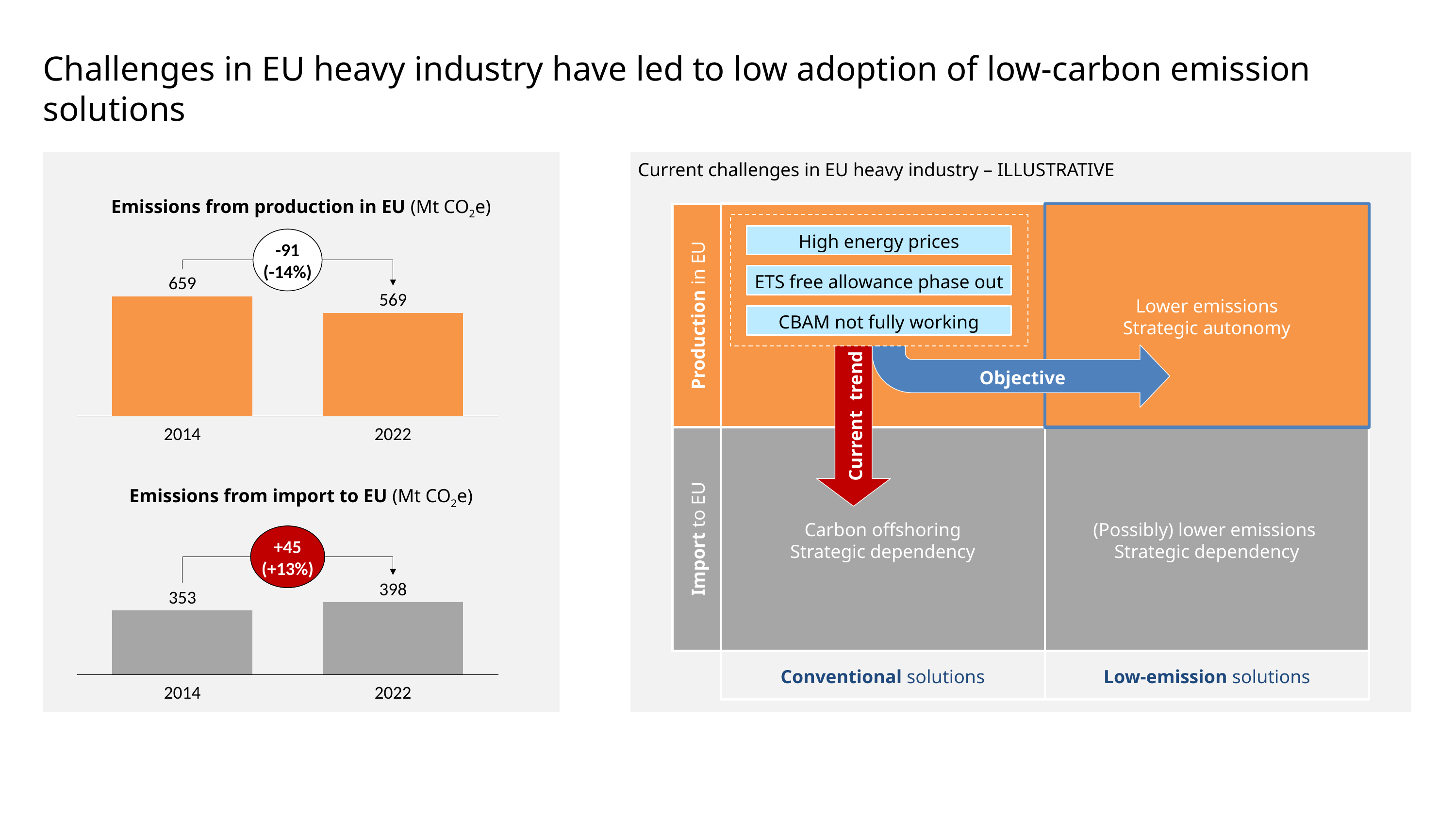
In the 'Emissions from import to EU' chart, what is the difference between the 2022 and 2014 values? 45 In the 'Emissions from import to EU' chart, what is the value for 2022? 398 How many bars are shown in the 'Emissions from production in EU' chart? 2 In the 'Emissions from production in EU' chart, do the values rise or fall from 2014 to 2022? fall In the 'Emissions from production in EU' chart, what is the value for 2022? 569 In the 'Emissions from import to EU' chart, which year has the higher value, 2014 or 2022? 2022 In the 'Emissions from import to EU' chart, do the values rise or fall from 2014 to 2022? rise In the 'Emissions from production in EU' chart, what is the value for 2014? 659 In the 'Emissions from production in EU' chart, what is the difference between the 2014 and 2022 values? 91 What unit is given in the title of the 'Emissions from production in EU' chart? Mt CO2e What kind of chart is the 'Emissions from import to EU' chart? bar chart In the 'Emissions from import to EU' chart, what is the value for 2014? 353